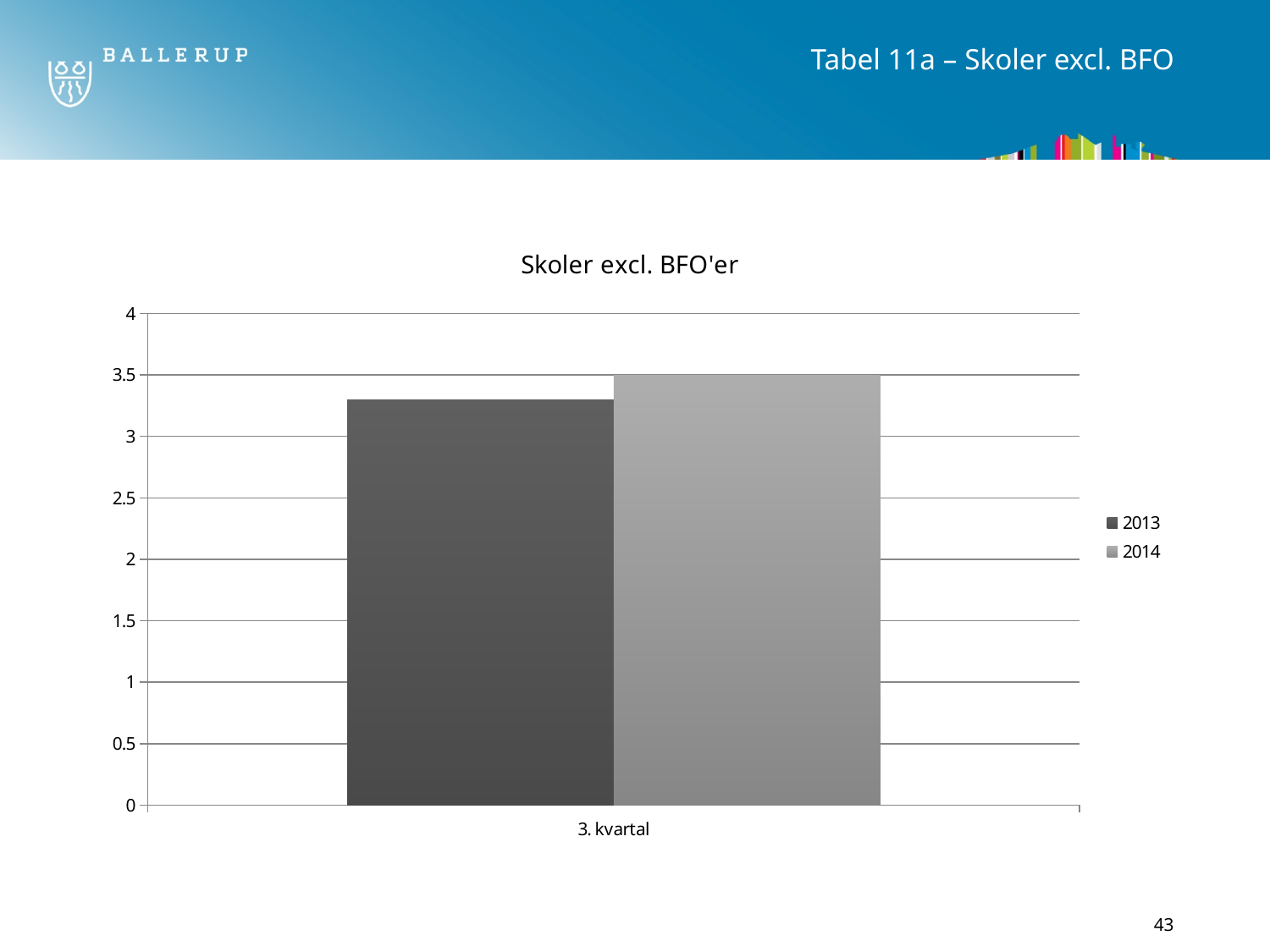
What is the value for 2014 in 3. kvartal? 3.5 Which series has the higher value in 3. kvartal, 2013 or 2014? 2014 What is the highest value shown on the y axis? 4 Is the value for 2014 in 3. kvartal greater or less than 3? greater Which series are listed in the legend? 2013 and 2014 What is the title of the chart? Skoler excl. BFO'er Is the value for 2013 in 3. kvartal greater or less than 3? greater What kind of chart is shown on the slide? bar chart How many series does the legend list? 2 How many categories are shown on the x axis? 1 Is the value for 2013 in 3. kvartal greater or less than 3.5? less What is the category label on the x axis? 3. kvartal